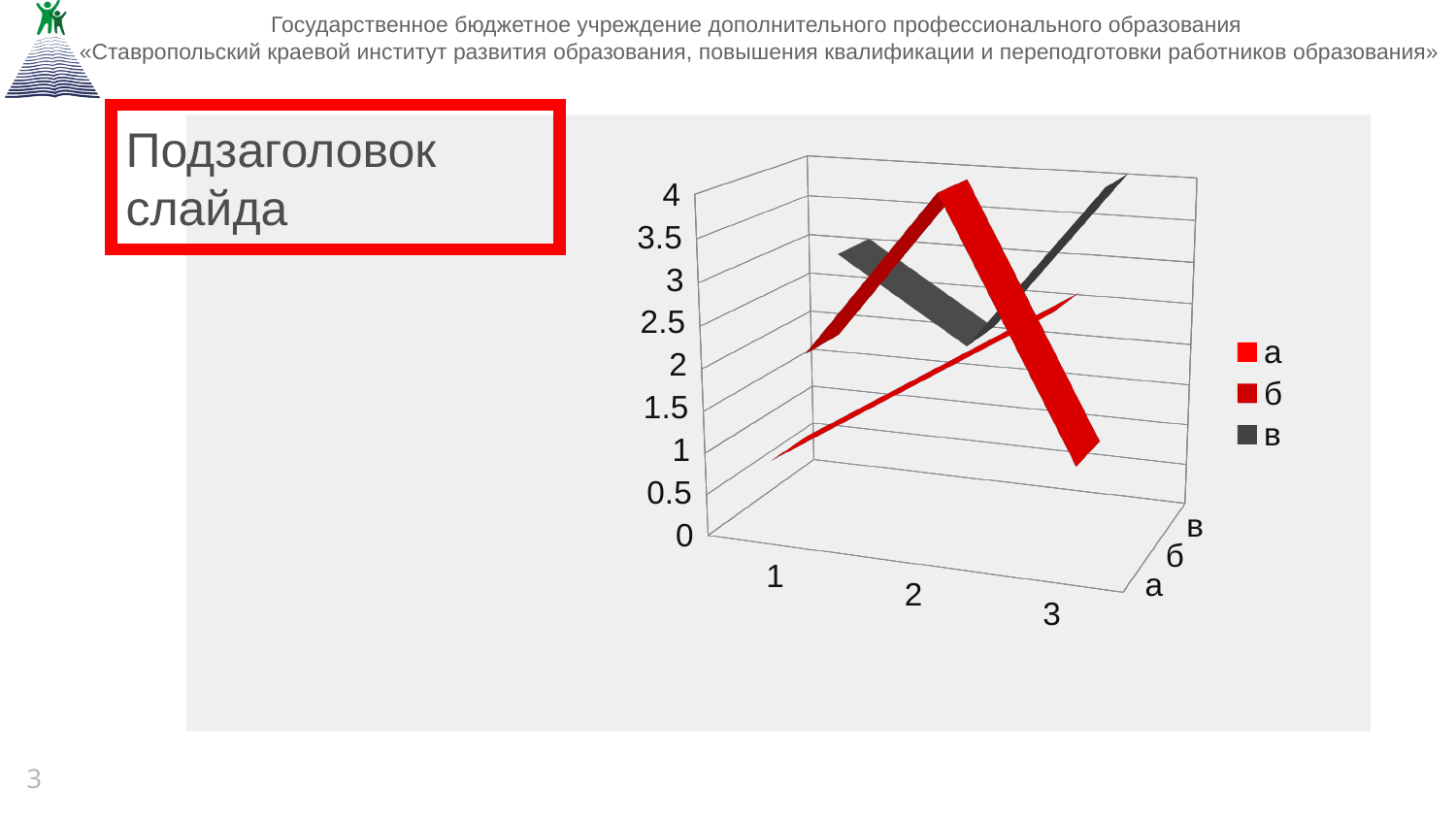
At which category does series в reach its highest value? 3 What are the series names listed in the legend? а, б, в What kind of chart is shown on the slide? line chart Does series б rise or fall from category 2 to category 3? fall Which colour represents series в in the legend? dark gray How many categories are shown along the x axis? 3 Does series в rise or fall from category 2 to category 3? rise At which category does series в reach its lowest value? 2 How many series does the legend list? 3 Does series а rise or fall from category 1 to category 3? rise At which category does series б reach its highest value? 2 At which category does series б reach its lowest value? 3